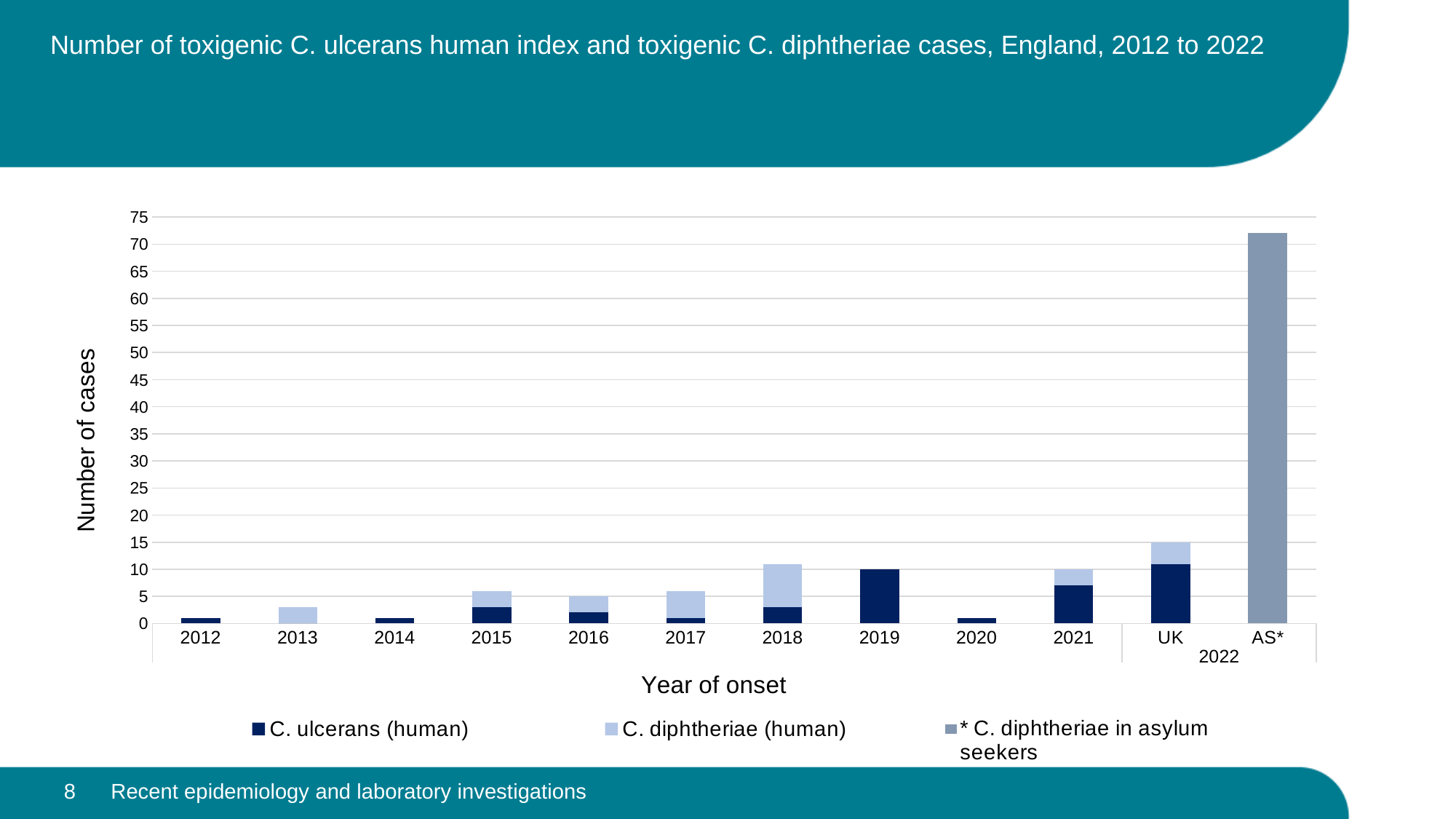
Which year has more C. ulcerans (human) cases, 2019 or 2021? 2019 What kind of chart is shown on the slide? Bar chart Is the total value for 2013 greater or less than 5? less Is the total value for 2021 greater or less than 5? greater What is the title of the y axis? Number of cases How many series does the legend list? 3 Which category has the tallest bar? AS* (2022) Which has the taller bar, 2019 or 2020? 2019 How many categories are shown along the x axis? 12 Is the value for AS* (2022) greater or less than 50? greater What is the title of the x axis? Year of onset What is the total number of cases for 2019? 10